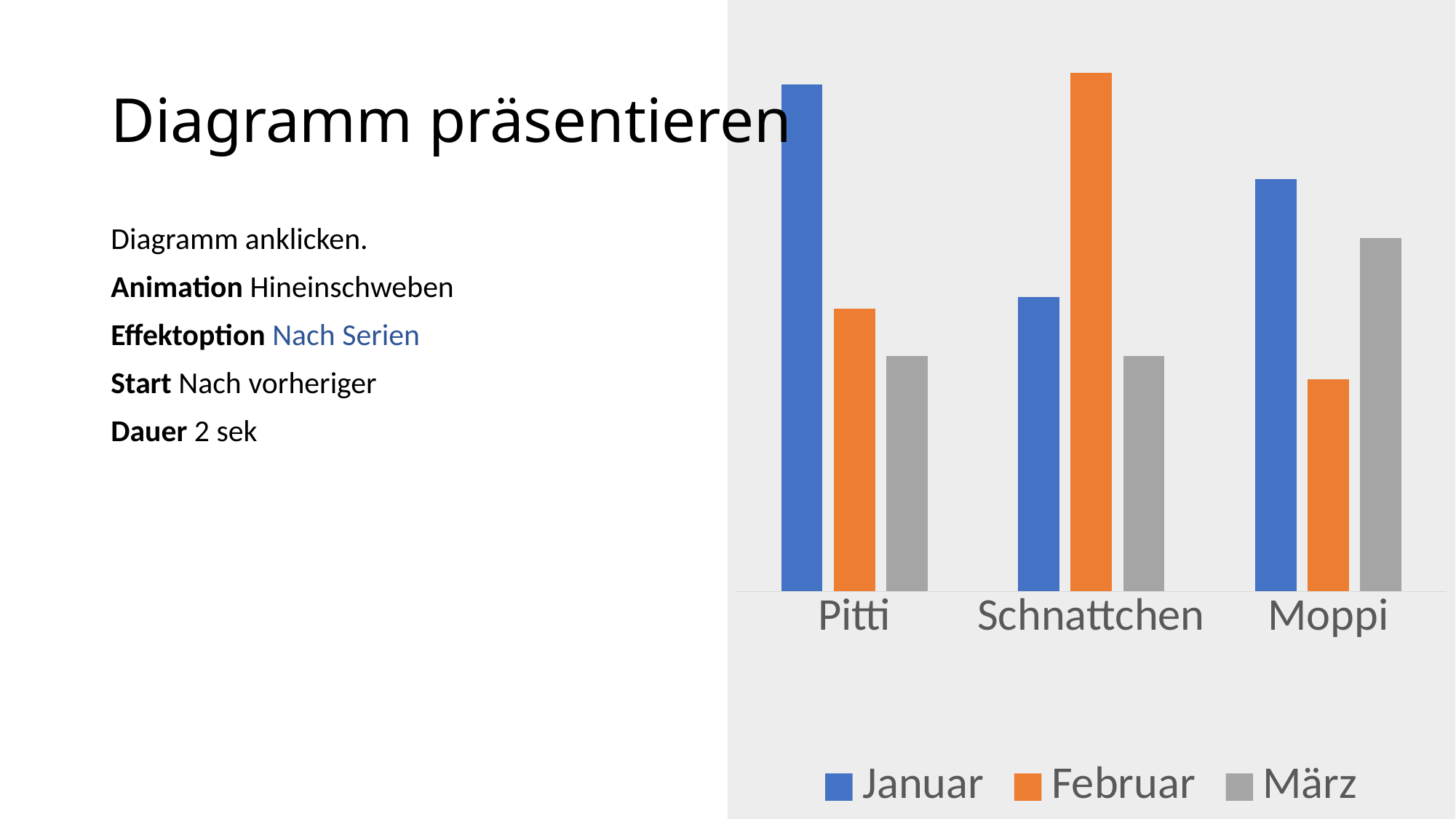
How many series does the chart's legend list? 3 For Moppi, which is larger: the Februar value or the März value? März How many categories are shown on the x axis of the chart? 3 Which category has the lowest value for the Januar series? Schnattchen Which category has the lowest value for the Februar series? Moppi For Pitti, which is larger: the Januar value or the Februar value? Januar Which category has the highest value for the Februar series? Schnattchen What colour represents the Februar series in the chart? orange What kind of chart is shown on the slide? bar chart Which category has the highest value for the März series? Moppi Which category has the highest value for the Januar series? Pitti What are the entries listed in the chart's legend? Januar, Februar, März